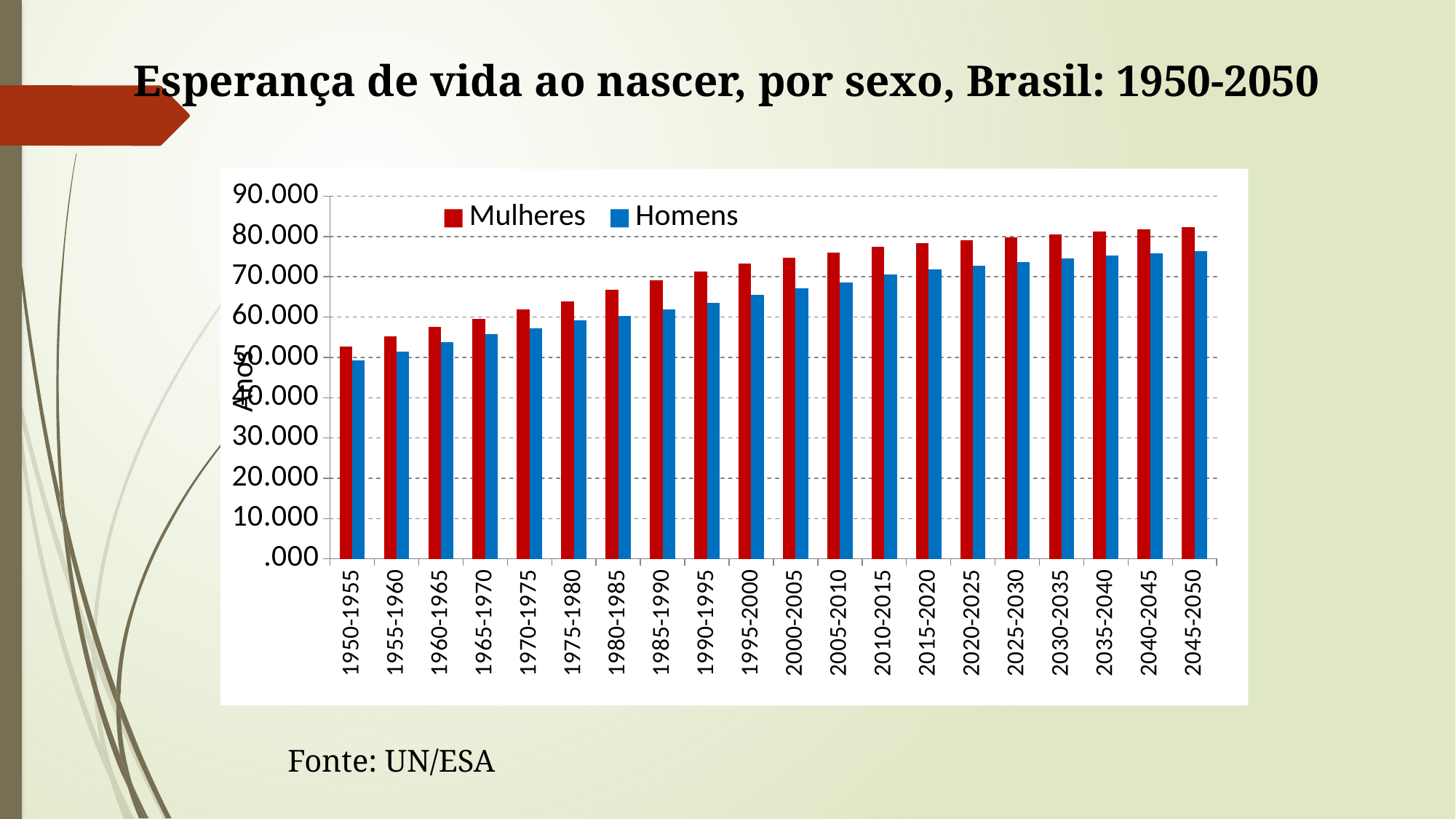
In which period is the value for Homens lowest? 1950-1955 In which period is the value for Mulheres highest? 2045-2050 Is the value for Mulheres in 2045-2050 greater or less than 80.000? greater How many time periods are shown on the x axis? 20 In 1950-1955, which is larger, the value for Mulheres or the value for Homens? Mulheres Is the value for Mulheres in 2000-2005 greater or less than 70.000? greater Which series is shown in red in the legend? Mulheres What kind of chart is shown on the slide? bar chart Do the values for Mulheres rise or fall from 1950-1955 to 2045-2050? rise Is the value for Homens in 2045-2050 greater or less than 80.000? less How many series does the legend list? 2